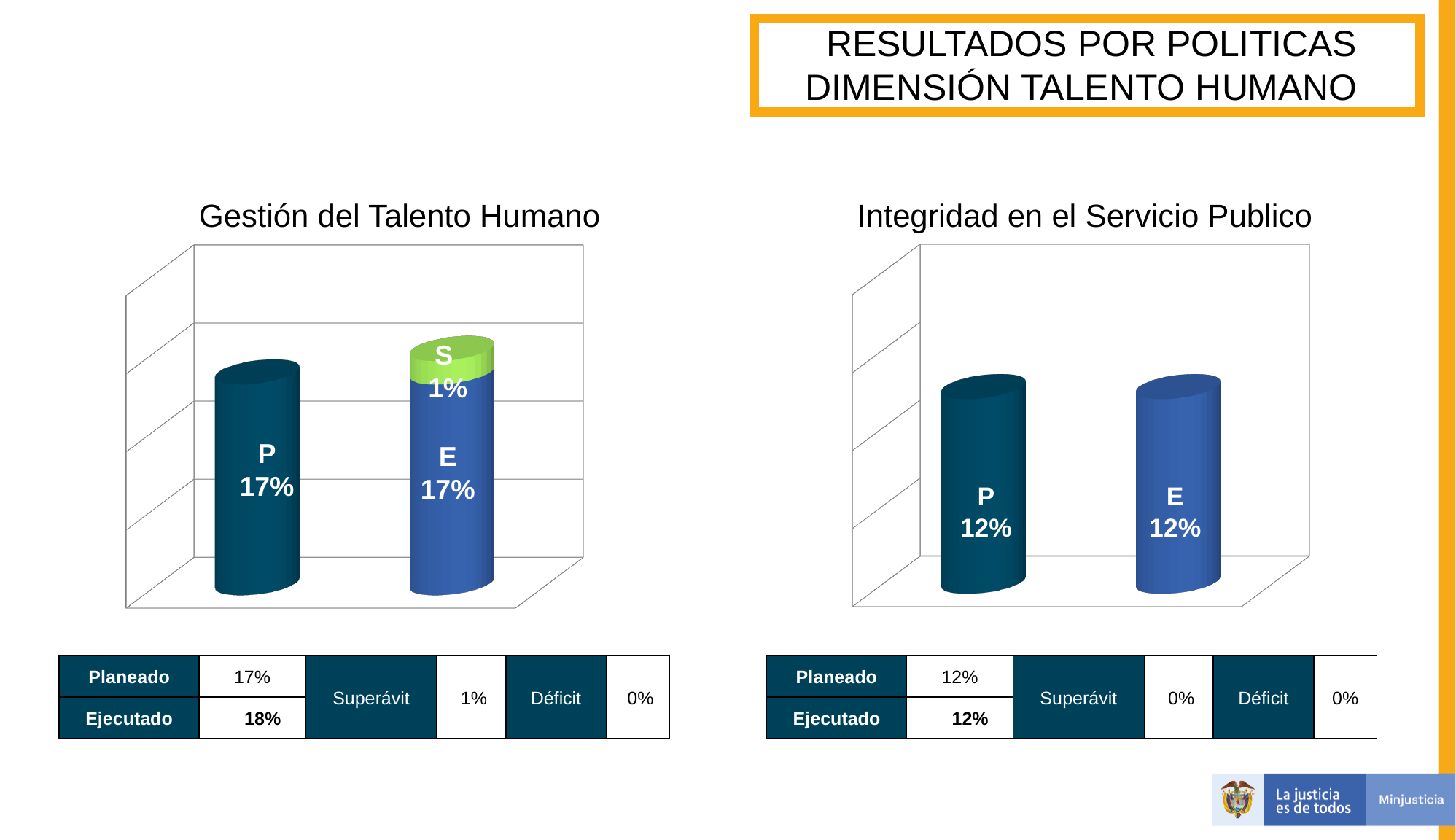
What is the title of the chart on the right side of the slide? Integridad en el Servicio Publico In the 'Integridad en el Servicio Publico' chart, what is the value labelled on the E bar? 12% In the 'Integridad en el Servicio Publico' chart, what is the difference between the P value and the E value? 0% What kind of chart is the 'Gestión del Talento Humano' chart? Bar chart How many bars are plotted in the 'Gestión del Talento Humano' chart? 2 In the 'Integridad en el Servicio Publico' chart, what is the value labelled on the P bar? 12% In the 'Gestión del Talento Humano' chart, what is the value labelled on the P bar? 17% In the 'Gestión del Talento Humano' chart, what is the value of the green S segment on top of the E bar? 1% In the 'Gestión del Talento Humano' chart, what is the difference between the E segment value and the S segment value? 16% In the 'Gestión del Talento Humano' chart, what colour is the S segment on top of the E bar? Green How many bars are plotted in the 'Integridad en el Servicio Publico' chart? 2 In the 'Gestión del Talento Humano' chart, what is the total of the stacked E bar (E plus S)? 18%